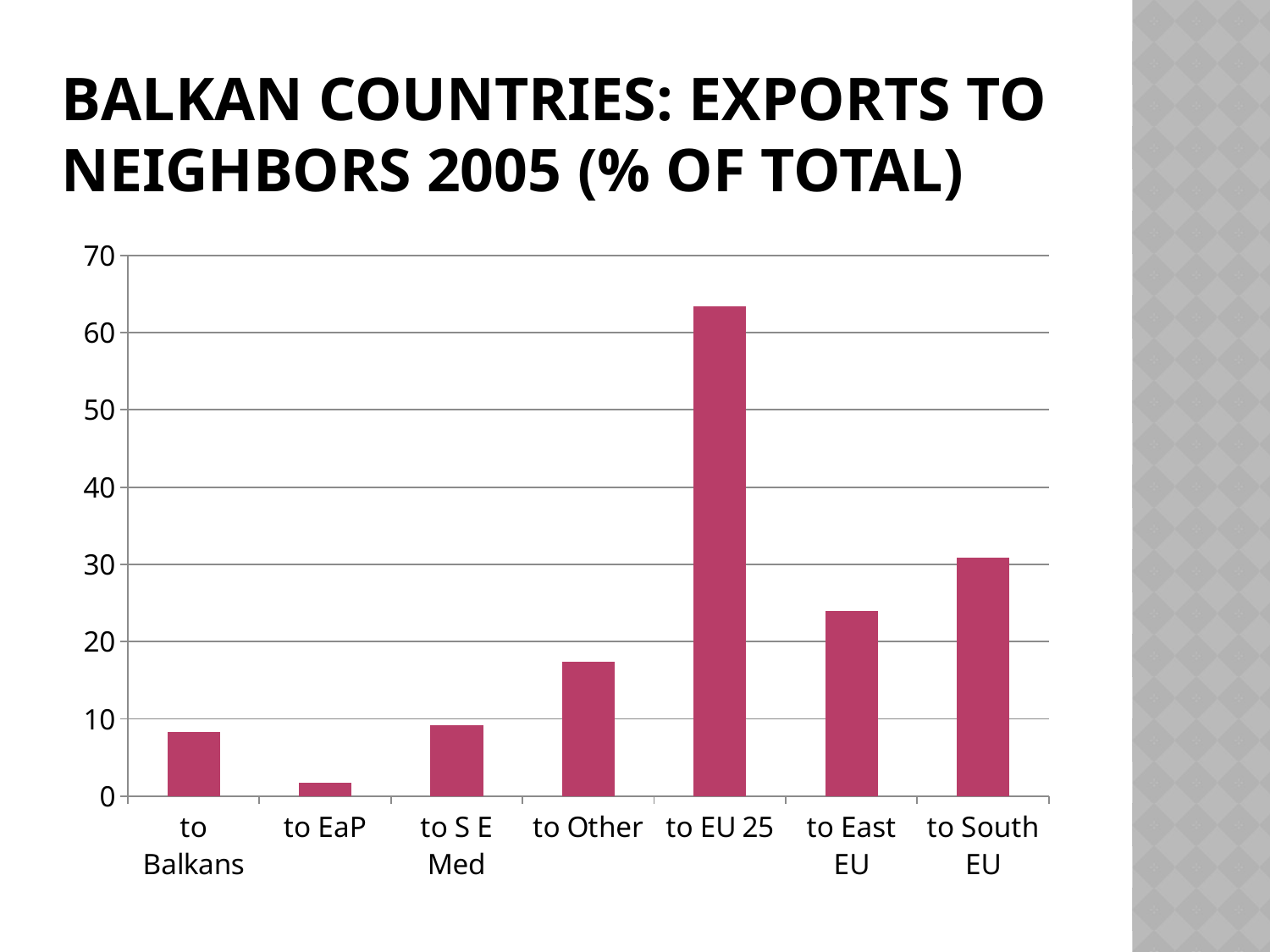
Is the value for to South EU greater or less than 20? greater What is the title of the slide? Balkan Countries: Exports to Neighbors 2005 (% of Total) Which is larger, the value for to South EU or the value for to East EU? to South EU Which category has the highest value? to EU 25 Is the value for to EU 25 greater or less than 60? greater Is the value for to Other greater or less than 20? less Which category has the lowest value? to EaP What kind of chart is shown on the slide? bar chart Which is larger, the value for to Other or the value for to Balkans? to Other How many categories are shown on the x axis? 7